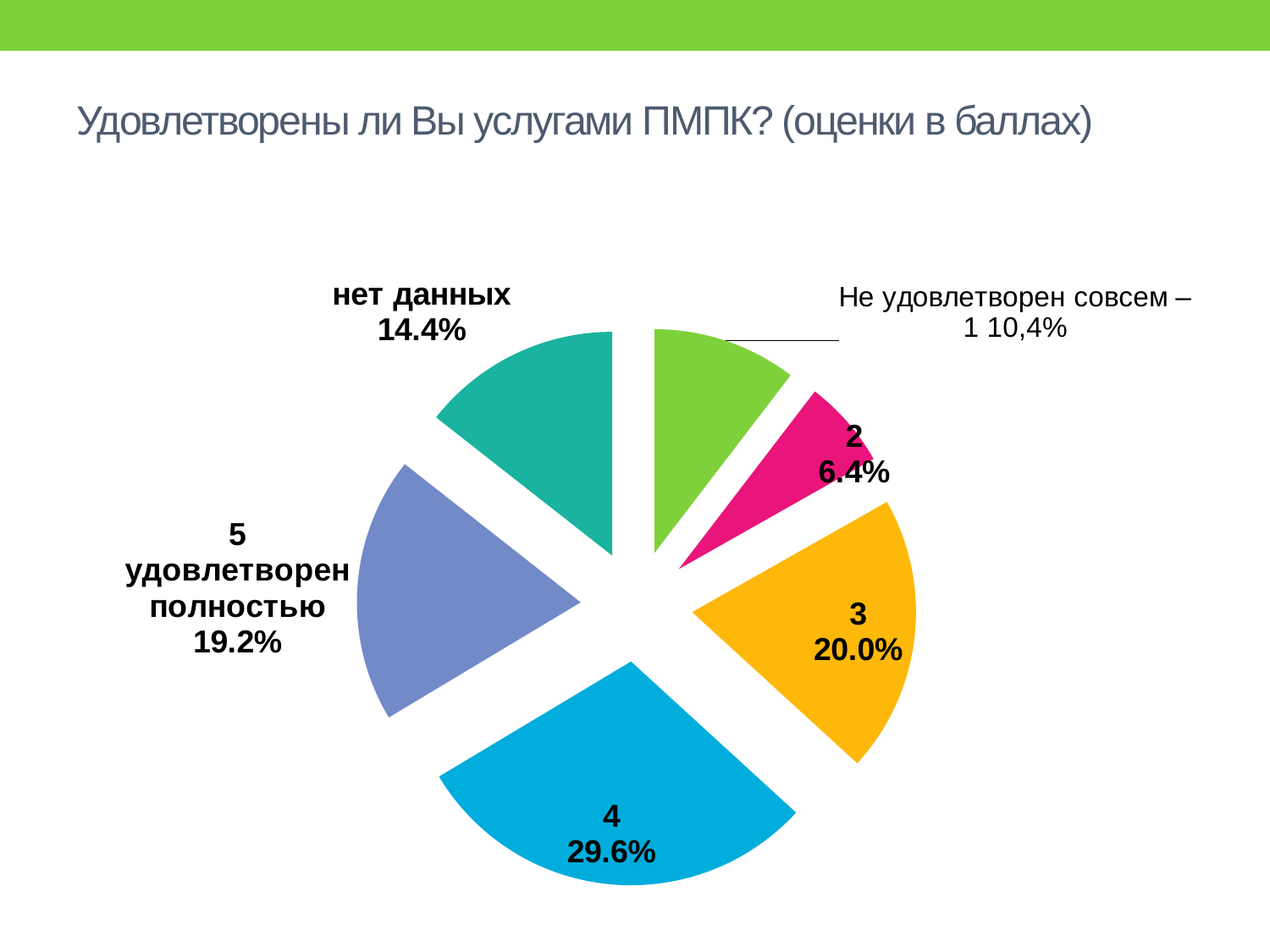
What is the difference between the shares for "4" and "3"? 9.6% Which is larger, the share for "5 удовлетворен полностью" or the share for "нет данных"? 5 удовлетворен полностью What share of the pie is labelled "Не удовлетворен совсем – 1"? 10,4% Which slice of the pie chart is the smallest? 2 What share of the pie is labelled "5 удовлетворен полностью"? 19.2% What share of the pie is labelled "нет данных"? 14.4% What share of the pie is labelled "3"? 20.0% Which slice of the pie chart is the largest? 4 How many slices does the pie chart have? 6 What kind of chart is shown on the slide? pie chart What share of the pie is labelled "2"? 6.4% What share of the pie is labelled "4"? 29.6%